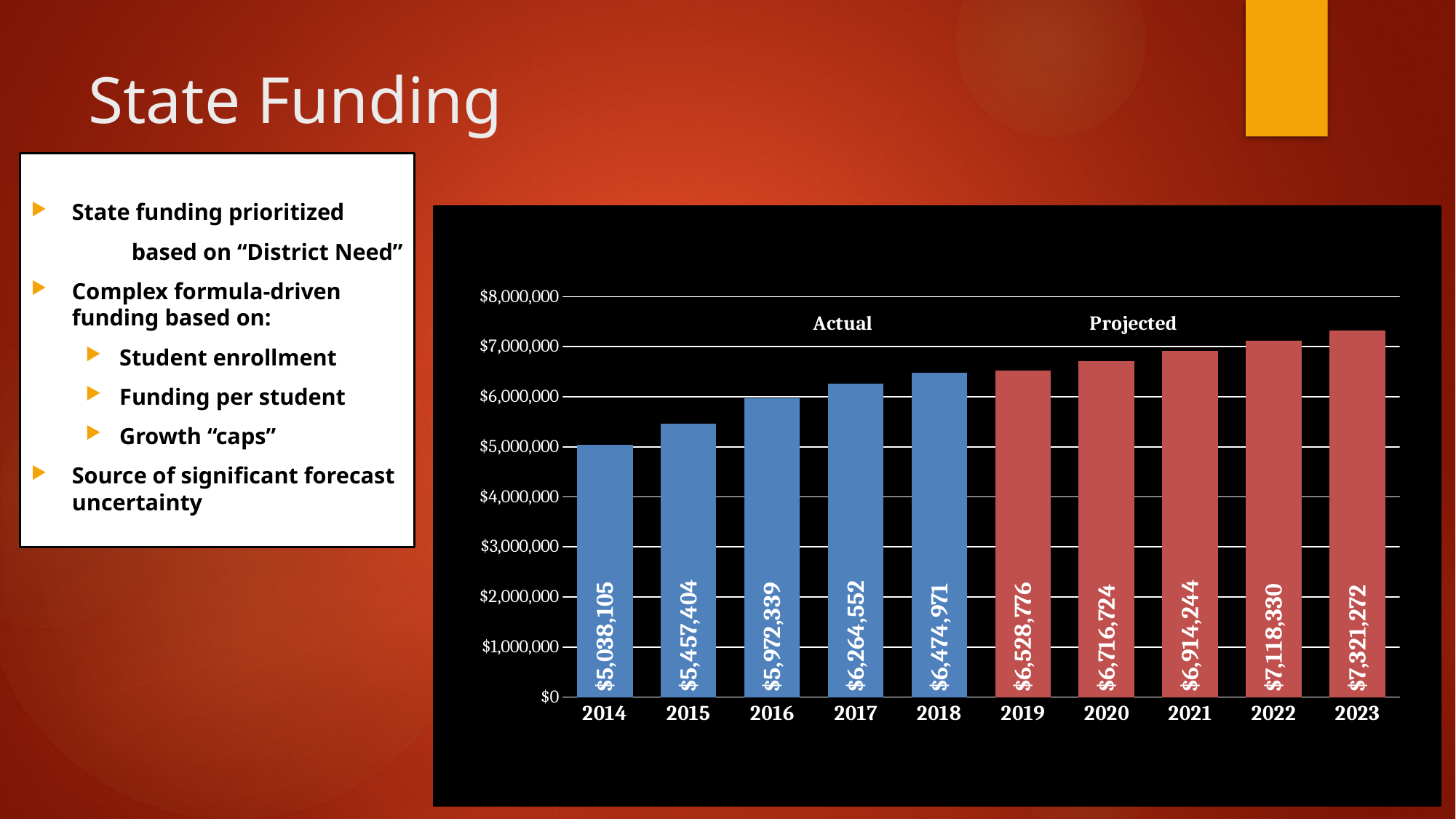
What is the state funding value shown for 2017? $6,264,552 Which year has the larger state funding value, 2016 or 2021? 2021 What is the state funding value shown for 2014? $5,038,105 What is the difference between the state funding values for 2023 and 2014? $2,283,167 What kind of chart is used to show state funding? bar chart Do the state funding values rise or fall from 2014 to 2023? rise What is the difference between the state funding values for 2018 and 2017? $210,419 How many years are shown on the x axis of the chart? 10 Which year has the lowest state funding value on the chart? 2014 Which year has the highest state funding value on the chart? 2023 What is the state funding value shown for 2020? $6,716,724 Is the state funding value for 2022 greater or less than $7,000,000? greater